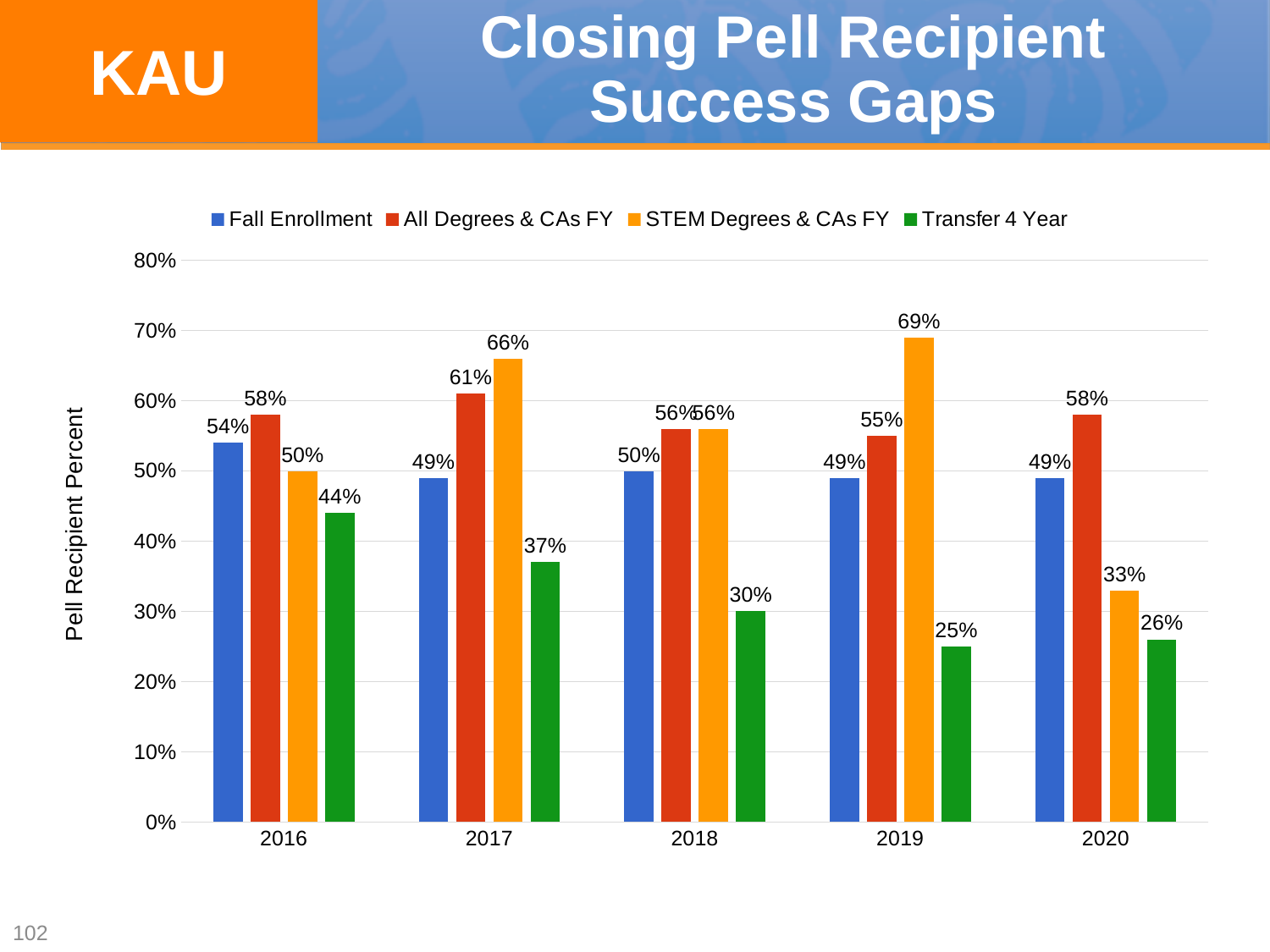
In which year is the STEM Degrees & CAs FY value highest? 2019 What is the Fall Enrollment value for 2016? 54% What is the Transfer 4 Year value for 2020? 26% Which is larger in 2020: the All Degrees & CAs FY value or the STEM Degrees & CAs FY value? All Degrees & CAs FY How many series does the legend list? 4 What is the All Degrees & CAs FY value for 2017? 61% In which year is the Transfer 4 Year value lowest? 2019 What is the STEM Degrees & CAs FY value for 2019? 69% What kind of chart is shown on the slide? Bar chart What is the difference between the STEM Degrees & CAs FY value and the Transfer 4 Year value in 2019? 44% What is the label of the y axis? Pell Recipient Percent How many years are shown on the x axis? 5